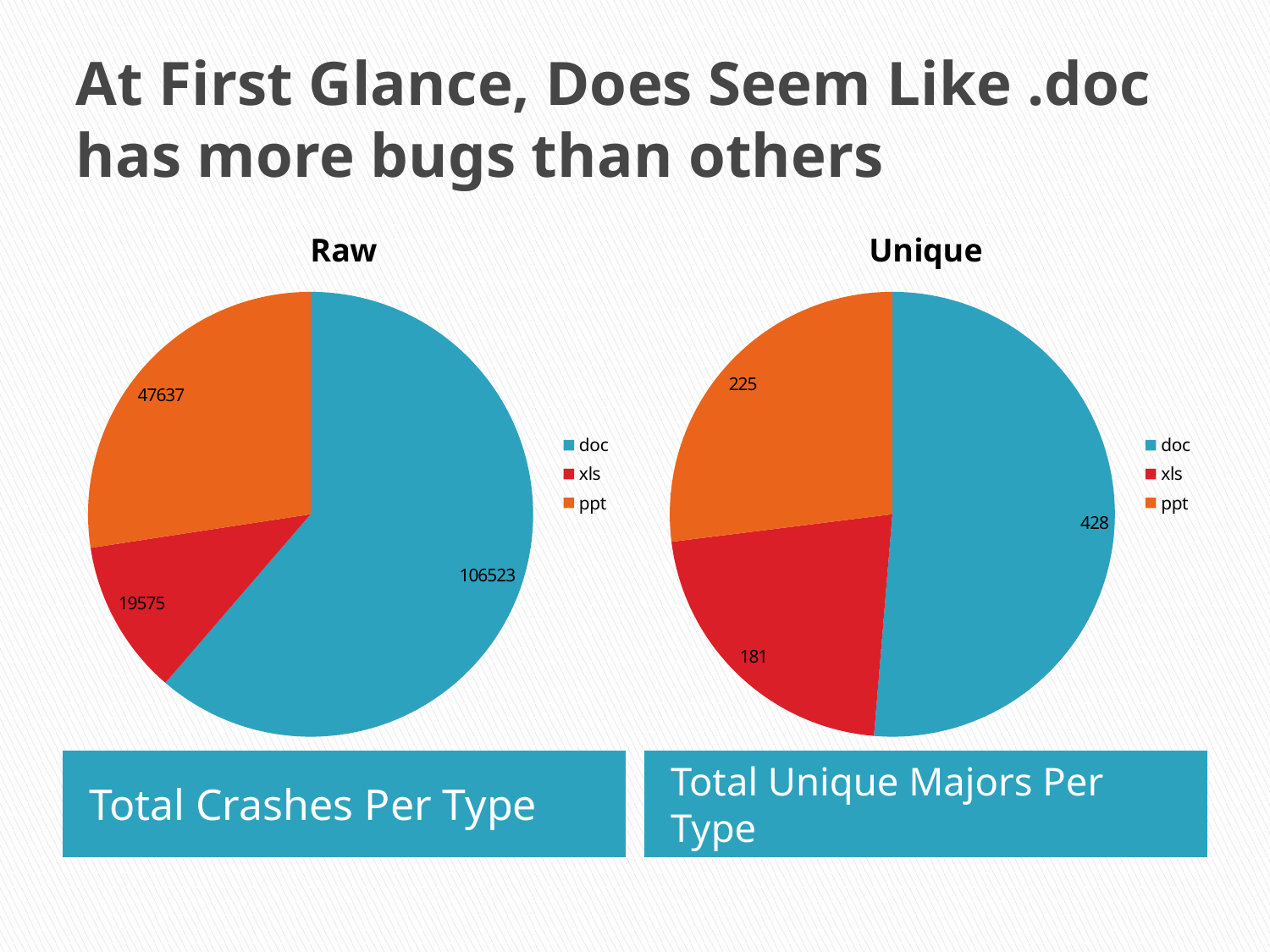
In the Unique pie chart, which is larger, ppt or xls? ppt In the Unique pie chart, what share of the total does doc represent? 51.3% In the Raw pie chart, what is the difference between the doc and ppt values? 58886 In the Unique pie chart, what is the value for xls? 181 In the Unique pie chart, which category has the smallest slice? xls In the Raw pie chart, which category has the largest slice? doc What type of chart is the Unique chart? pie chart In the Raw pie chart, what is the value for xls? 19575 In the Raw pie chart, what is the value for doc? 106523 In the Unique pie chart, what is the difference between the doc and xls values? 247 How many categories does the Raw pie chart show? 3 In the Unique pie chart, what is the value for ppt? 225